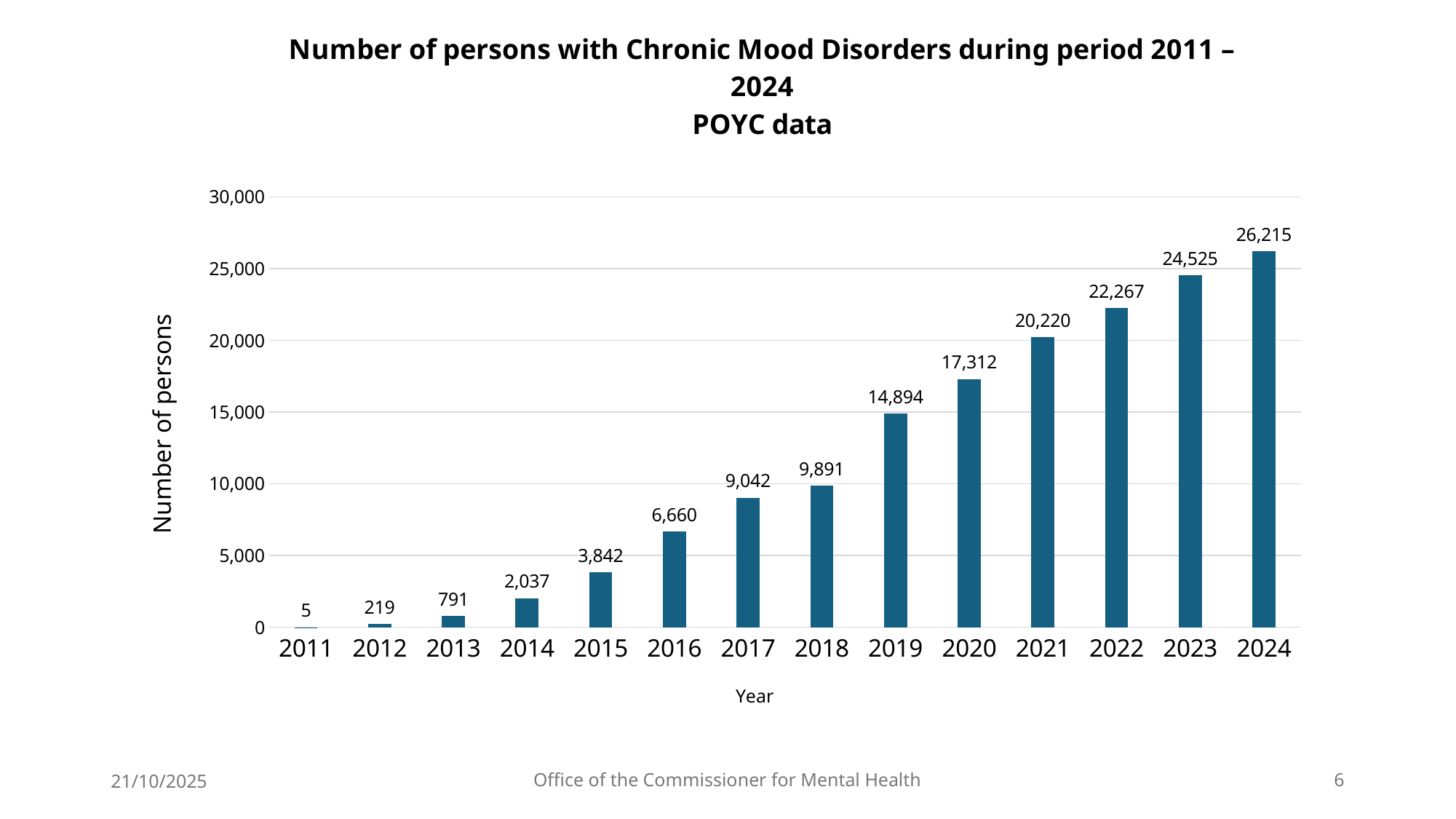
Which year has the lowest number of persons with chronic mood disorders? 2011 What is the number of persons with chronic mood disorders in 2013? 791 What is the number of persons with chronic mood disorders in 2024? 26,215 Which year has the highest number of persons with chronic mood disorders? 2024 Is the value for 2021 greater or less than 15,000? greater Which year has more persons with chronic mood disorders, 2016 or 2020? 2020 What is the difference between the number of persons in 2024 and in 2023? 1,690 What kind of chart is shown on the slide? Bar chart What is the difference between the number of persons in 2018 and in 2017? 849 What is the number of persons with chronic mood disorders in 2019? 14,894 How many years are shown on the x axis of the chart? 14 Do the values rise or fall from 2011 to 2024? Rise